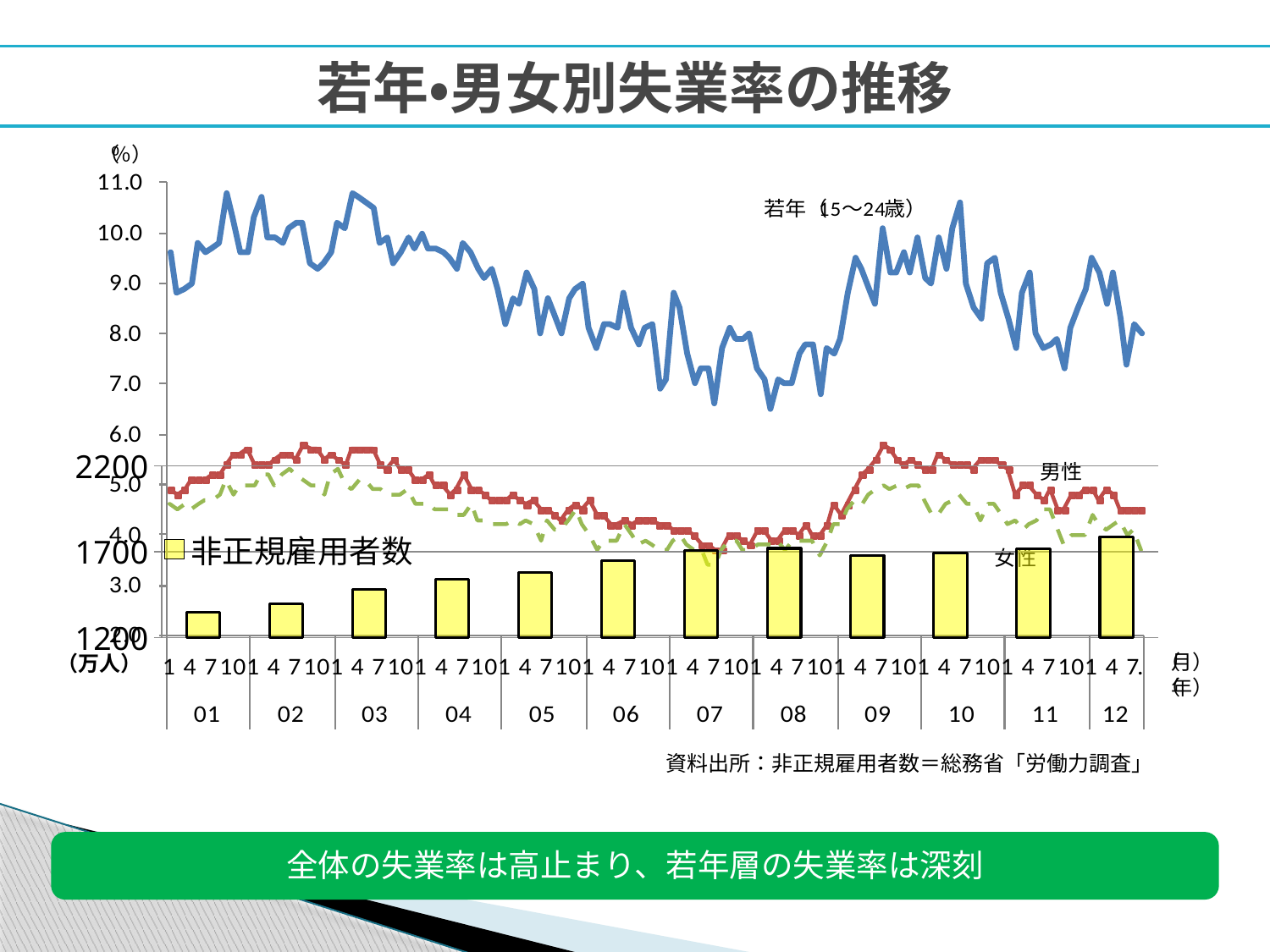
What kind of chart is shown on the slide? A combined line and bar chart What is the title of the chart on this slide? 若年・男女別失業率の推移 Is the 若年（15～24歳） unemployment rate line ever below 6.0%? No Is the 非正規雇用者数 bar for 01 greater or less than 1700 万人? less How many entries does the legend of the chart list? 1 How many years are shown along the x axis of the chart? 12 Which year has the shortest 非正規雇用者数 bar? 01 Is the 非正規雇用者数 bar for 12 greater or less than 2200 万人? less Which year has the tallest 非正規雇用者数 bar? 12 Do the 非正規雇用者数 bars generally rise or fall from 01 to 12? rise Which line is higher throughout the chart, 若年（15～24歳） or 男性? 若年（15～24歳） Which line is generally higher, 男性 or 女性? 男性